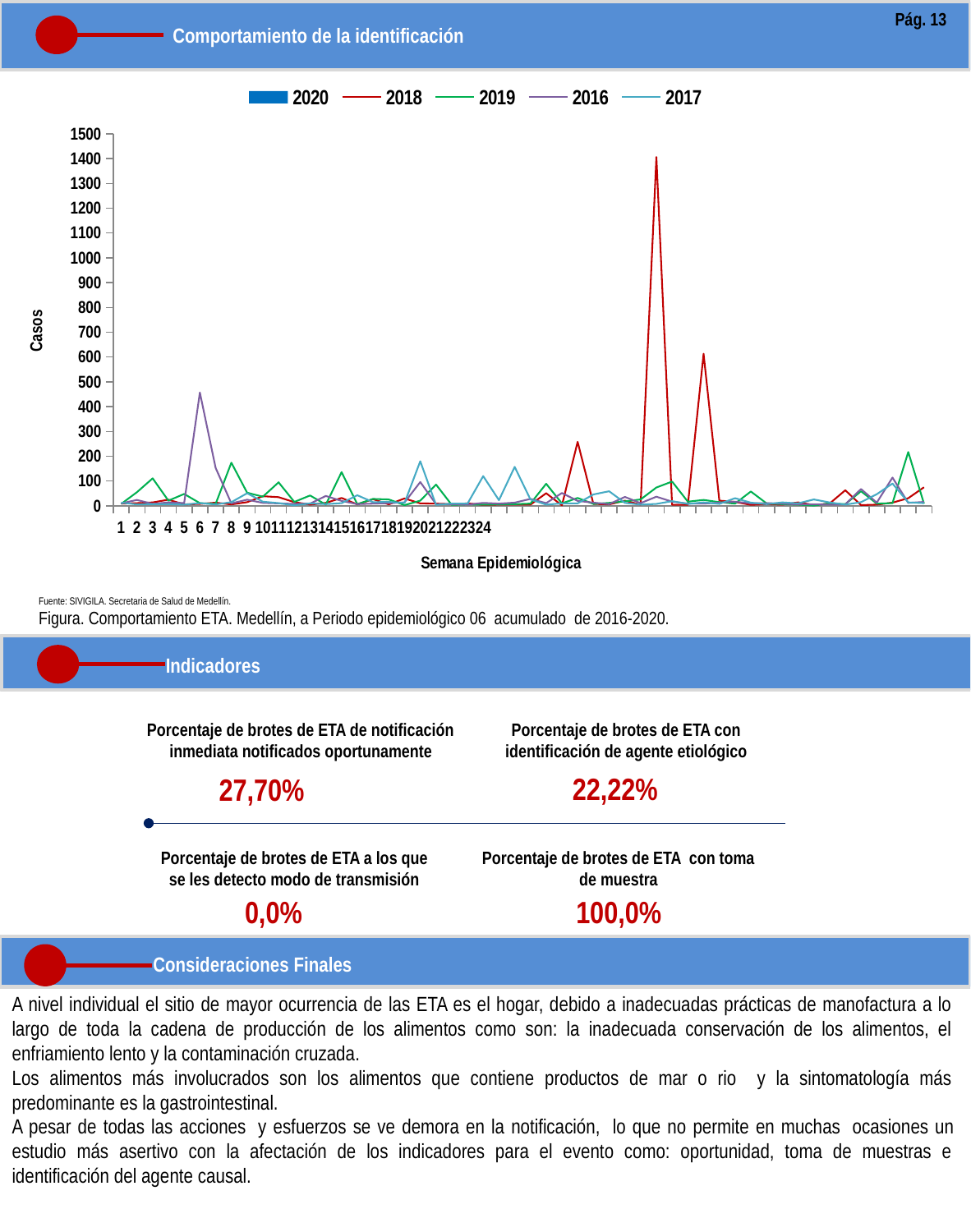
Which years are listed in the chart legend? 2020, 2018, 2019, 2016, 2017 Is the peak of the 2016 series at week 6 greater or less than 300? greater Is the highest value of the 2017 series greater or less than 300? less Is the highest value of the 2019 series greater or less than 400? less Which is larger, the highest peak of the 2018 series or the highest peak of the 2016 series? 2018 Which series reaches the highest value on the chart? 2018 What is the title of the vertical axis of the chart? Casos How many series does the legend of the chart list? 5 What kind of chart is shown under 'Comportamiento de la identificación'? Combination bar and line chart